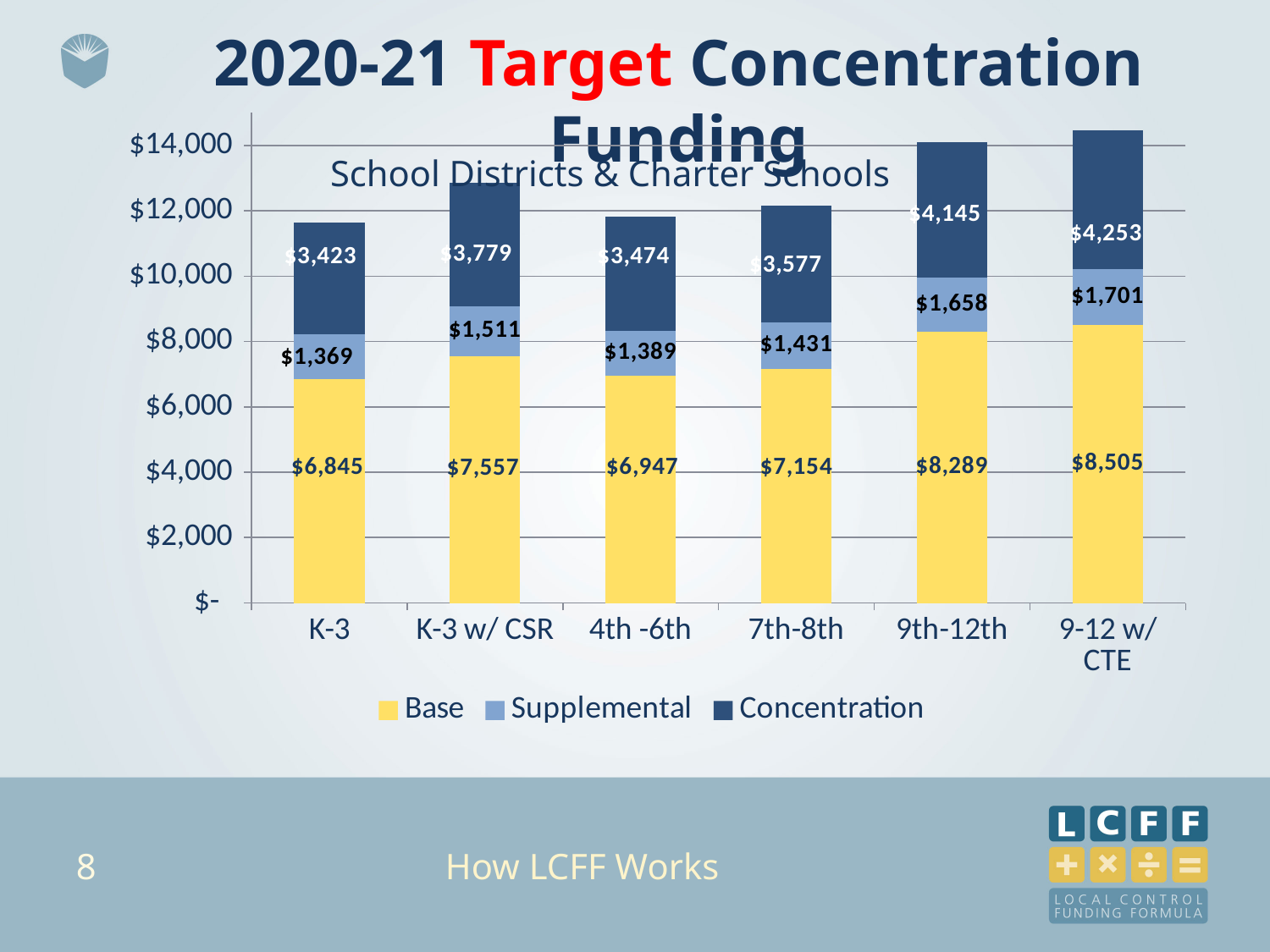
What is the Concentration value for 7th-8th? $3,577 What is the total of the stacked bar for K-3? $11,637 What kind of chart is shown on the slide? Stacked bar chart Which category has the lowest Concentration value? K-3 Which category has the highest Base value? 9-12 w/ CTE How many categories are shown on the x axis? 6 What is the difference between the Base values for 9-12 w/ CTE and K-3? $1,660 What is the Base value for 9th-12th? $8,289 How many series does the legend list? 3 What is the Supplemental value for K-3 w/ CSR? $1,511 Which is larger, the Supplemental value for 4th -6th or for 7th-8th? 7th-8th What is the total of the stacked bar for 9-12 w/ CTE? $14,459